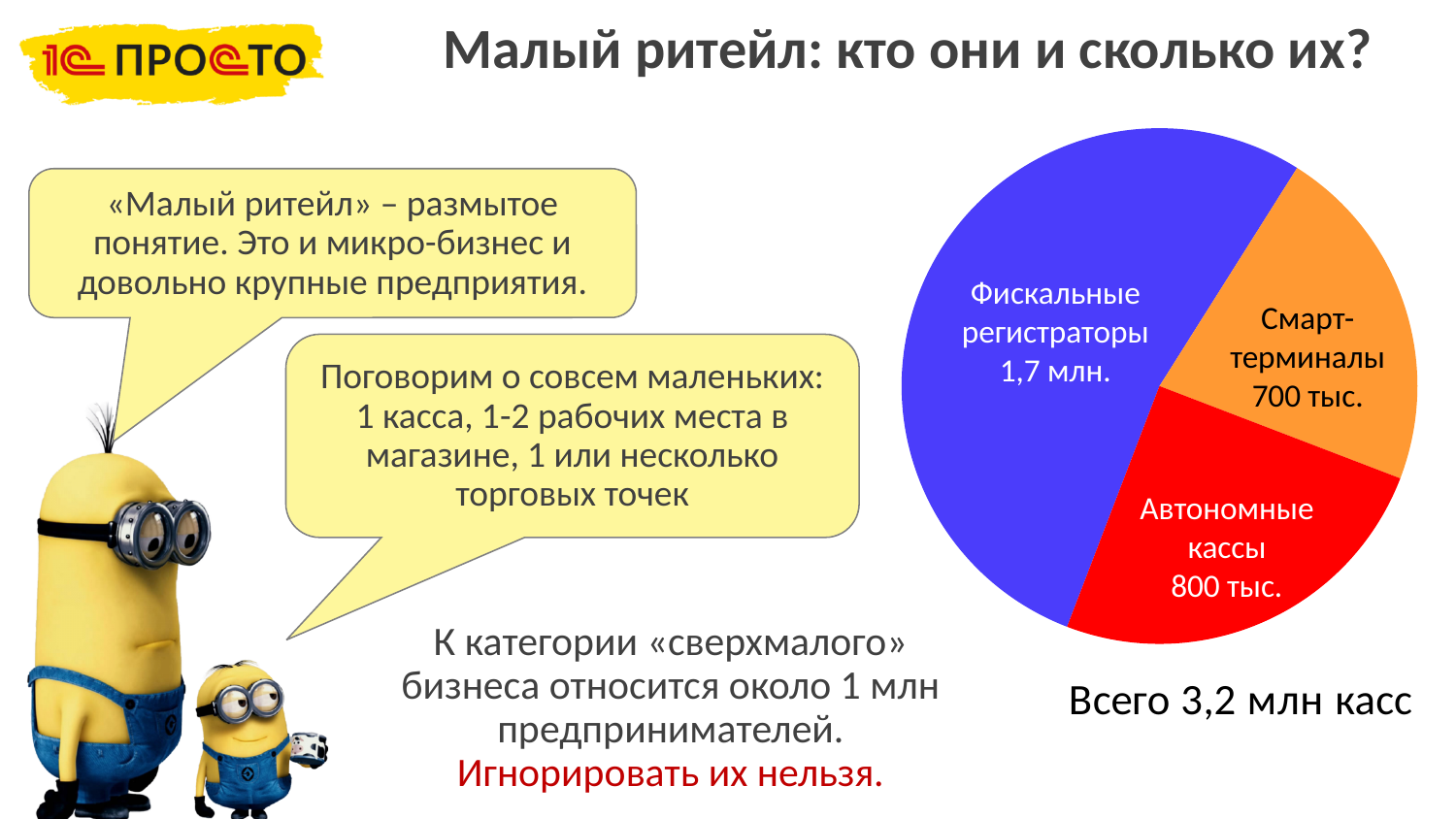
Which is larger: Автономные кассы or Смарт-терминалы? Автономные кассы What value is shown for Автономные кассы in the pie chart? 800 тыс. What type of chart is shown on the slide? pie chart What value is shown for Смарт-терминалы in the pie chart? 700 тыс. What colour is the Смарт-терминалы slice in the pie chart? orange What is the difference between the values for Автономные кассы and Смарт-терминалы? 100 тыс. How many categories does the pie chart show? 3 What is the total number of cash registers stated below the pie chart? 3,2 млн касс What value is shown for Фискальные регистраторы in the pie chart? 1,7 млн. What share of the total 3,2 млн do Автономные кассы represent? 25% Which category has the smallest slice of the pie chart? Смарт-терминалы Which category has the largest slice of the pie chart? Фискальные регистраторы